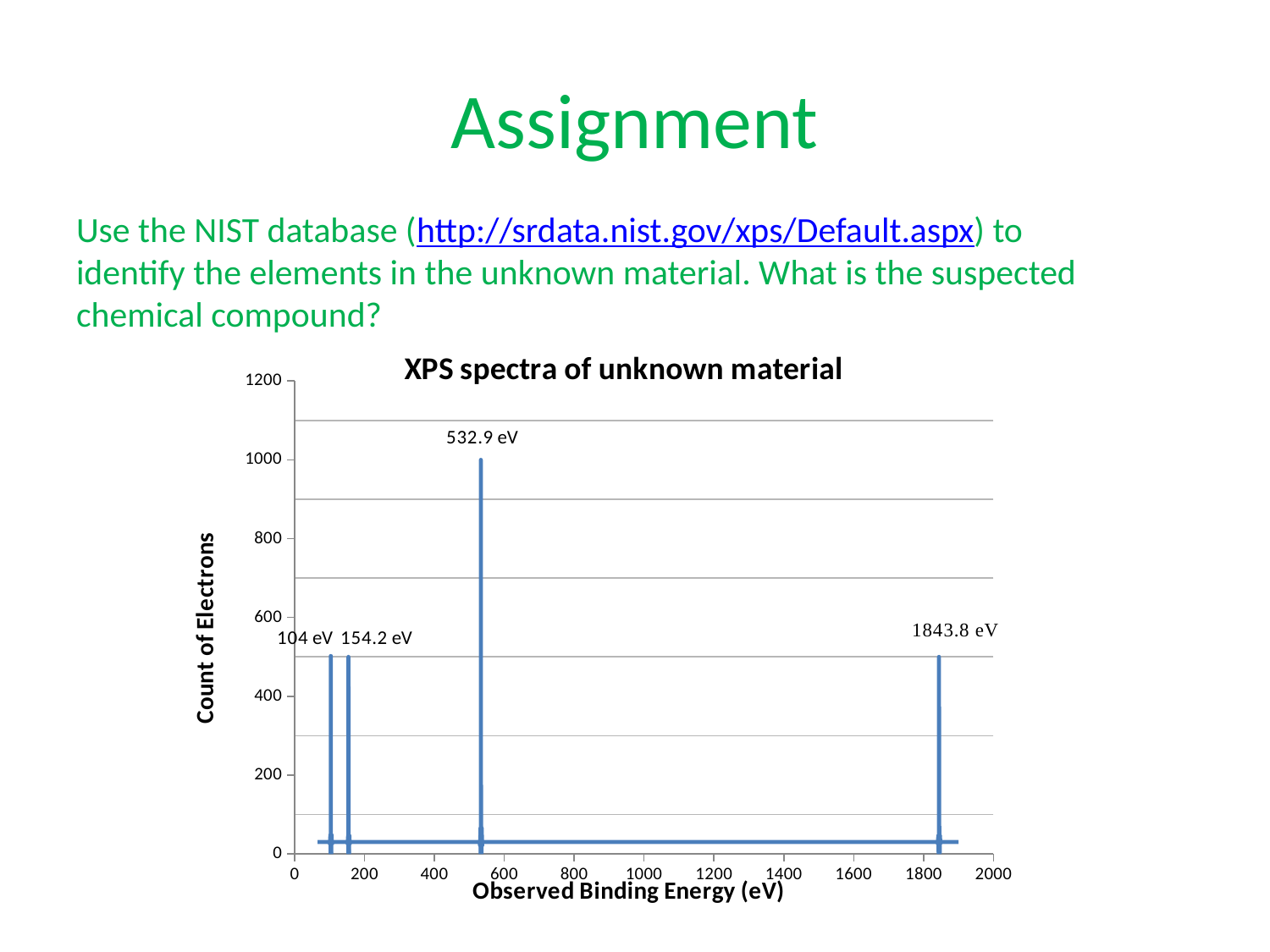
Is the count of electrons at the 104 eV peak greater or less than 600? less What count of electrons does the peak at 532.9 eV reach? 1000 At which binding energy is the tallest peak in the chart? 532.9 eV How many labeled peaks are shown in the chart? 4 Is the count of electrons at the 1843.8 eV peak greater or less than 400? greater What is the label of the x axis of the chart? Observed Binding Energy (eV) What kind of chart is shown on the slide? line chart Is the count of electrons at the 154.2 eV peak greater or less than 800? less What is the title of the chart? XPS spectra of unknown material What is the binding energy of the leftmost labeled peak? 104 eV Which peak is taller, the one at 532.9 eV or the one at 1843.8 eV? 532.9 eV What is the binding energy of the rightmost labeled peak? 1843.8 eV